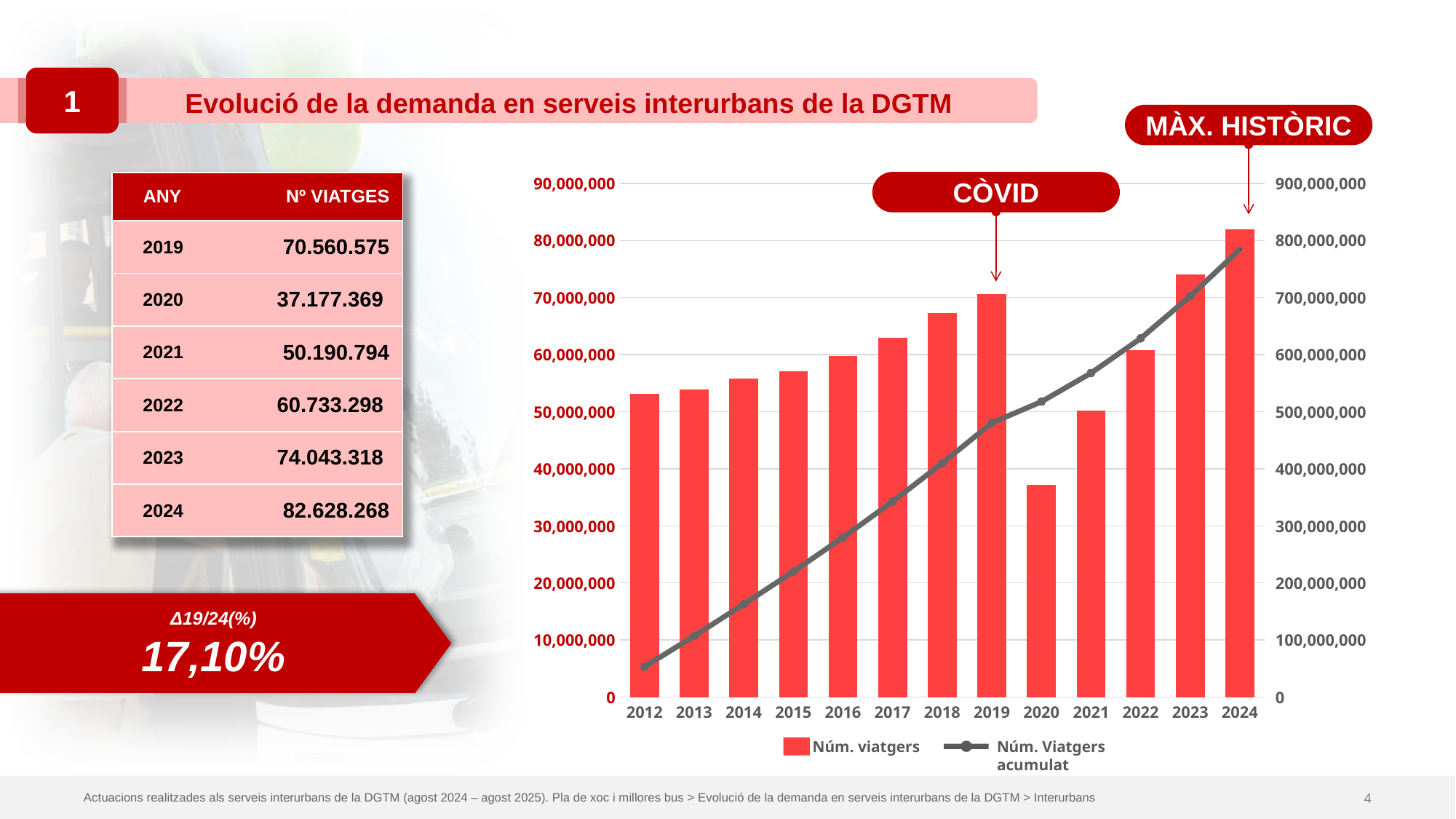
Is the Núm. viatgers bar for 2020 greater or less than 40,000,000? less Which year has the larger Núm. viatgers bar, 2019 or 2021? 2019 Is the Núm. Viatgers acumulat value for 2024 greater or less than 700,000,000 on the right axis? greater How many years are shown on the x axis of the chart? 13 Which year has the highest bar for Núm. viatgers? 2024 Do the Núm. viatgers bars rise or fall from 2012 to 2019? rise What kind of chart is shown on the slide? A bar chart combined with a line What annotation label points to the 2024 bar in the chart? MÀX. HISTÒRIC How many series does the chart legend list? 2 Is the Núm. viatgers bar for 2012 greater or less than 50,000,000? greater Which year has the lowest bar for Núm. viatgers? 2020 According to the table on the slide, what is the Nº viatges for 2024? 82.628.268